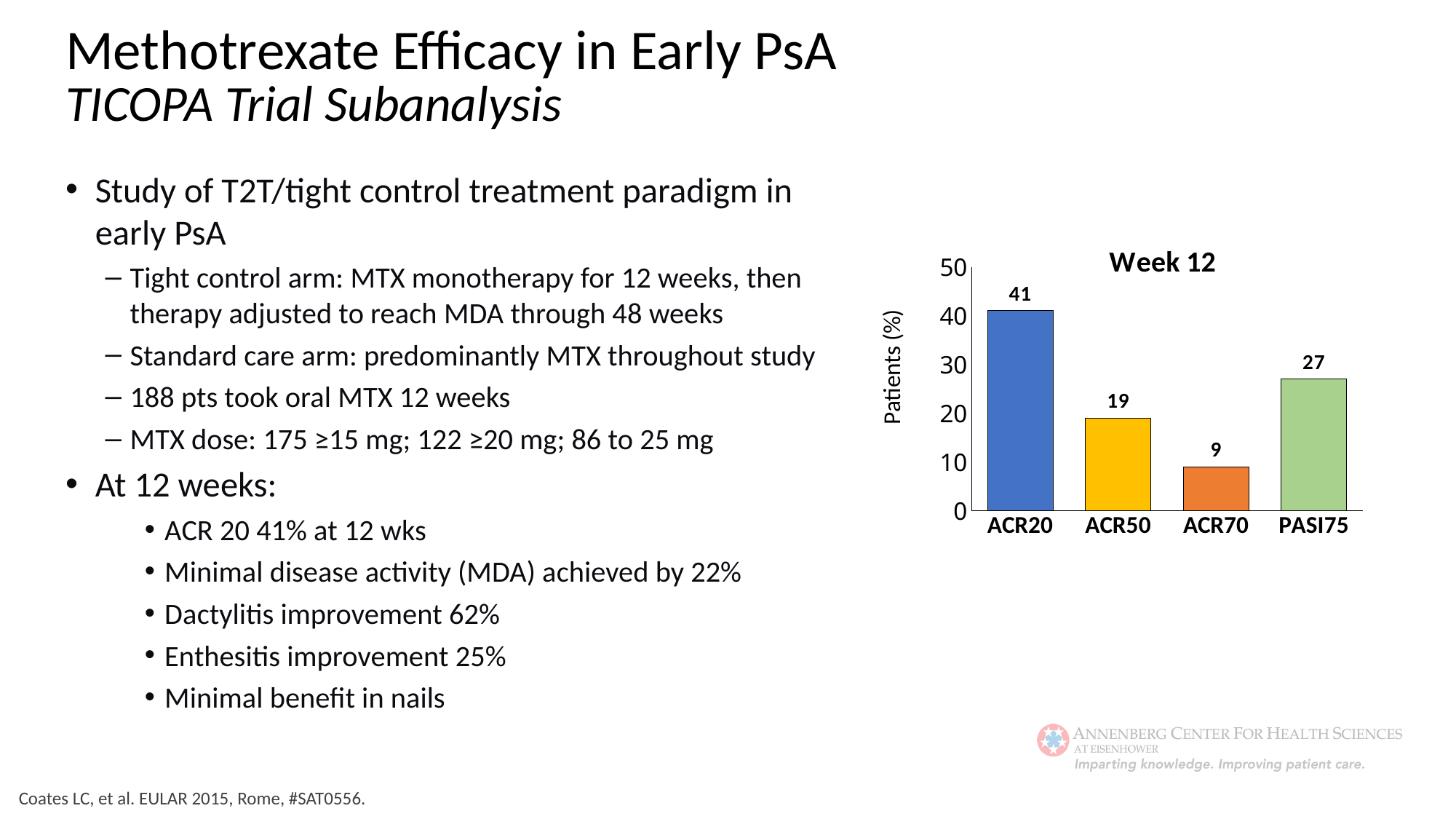
What kind of chart is the Week 12 chart? bar chart What is the value for ACR20 in the Week 12 chart? 41 What is the y-axis label of the Week 12 chart? Patients (%) Which is larger in the Week 12 chart, ACR50 or PASI75? PASI75 Which category has the highest value in the Week 12 chart? ACR20 What is the difference between the PASI75 and ACR70 values in the Week 12 chart? 18 Is the value for ACR50 in the Week 12 chart greater or less than 20? less What is the value for PASI75 in the Week 12 chart? 27 What is the difference between the ACR20 and ACR50 values in the Week 12 chart? 22 What is the value for ACR70 in the Week 12 chart? 9 Which category has the lowest value in the Week 12 chart? ACR70 How many categories are shown in the Week 12 chart? 4